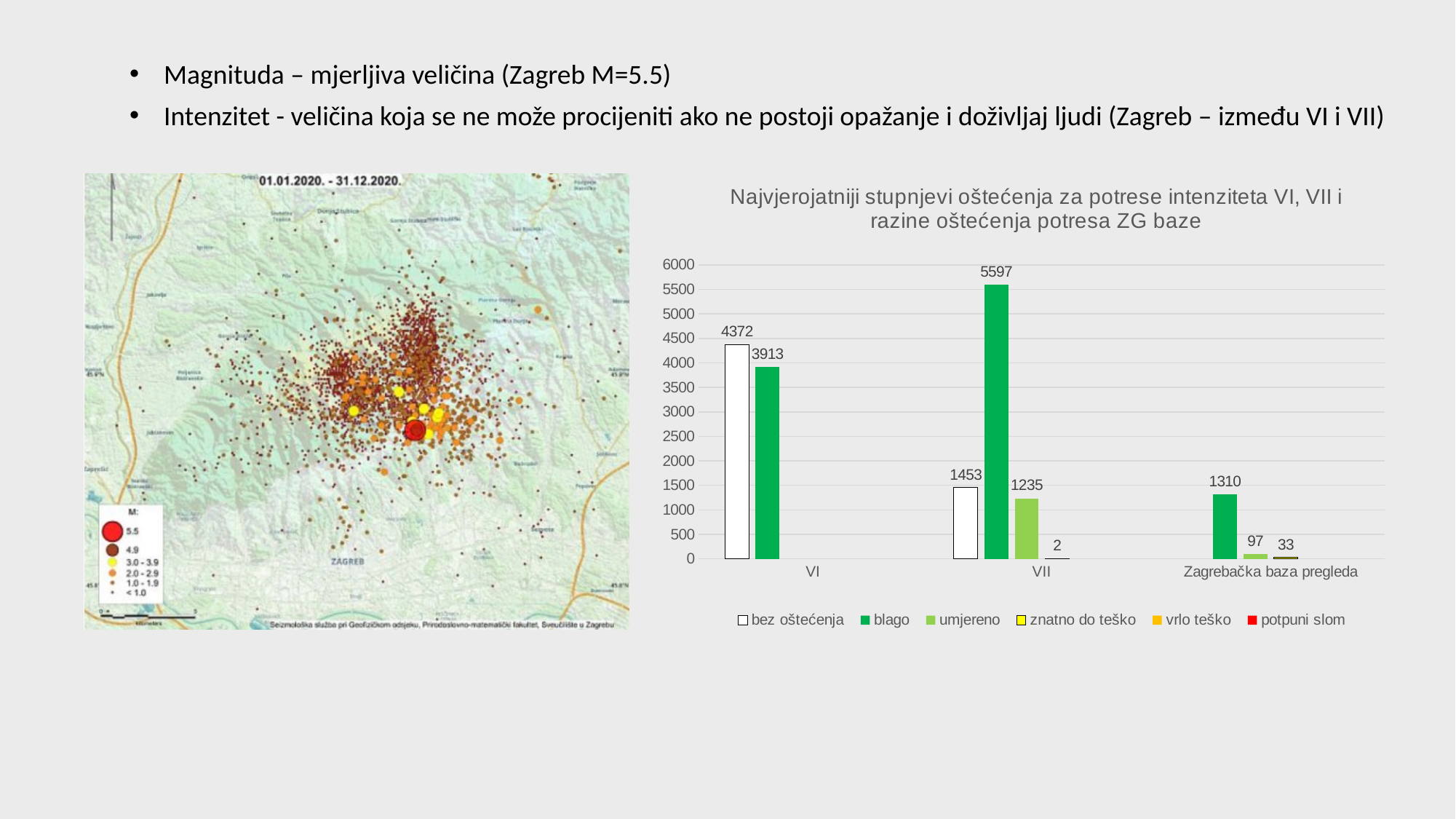
In the bar chart, what is the value of 'blago' for category VII? 5597 How many categories are shown on the x axis of the bar chart? 3 In the bar chart, what is the value of 'bez oštećenja' for category VI? 4372 In the bar chart, what is the value of 'znatno do teško' for category VII? 2 In the bar chart, what is the difference between 'bez oštećenja' and 'blago' for category VI? 459 In the bar chart, what is the difference between 'blago' for VII and 'blago' for 'Zagrebačka baza pregleda'? 4287 What type of chart is shown on the right side of the slide? bar chart In the bar chart, which category has the lowest 'umjereno' value? Zagrebačka baza pregleda How many series does the legend of the bar chart list? 6 In the bar chart, which category has the highest 'blago' value? VII In the bar chart, what is the value of 'umjereno' for 'Zagrebačka baza pregleda'? 97 In the bar chart, which is larger for category VII: 'bez oštećenja' or 'umjereno'? bez oštećenja